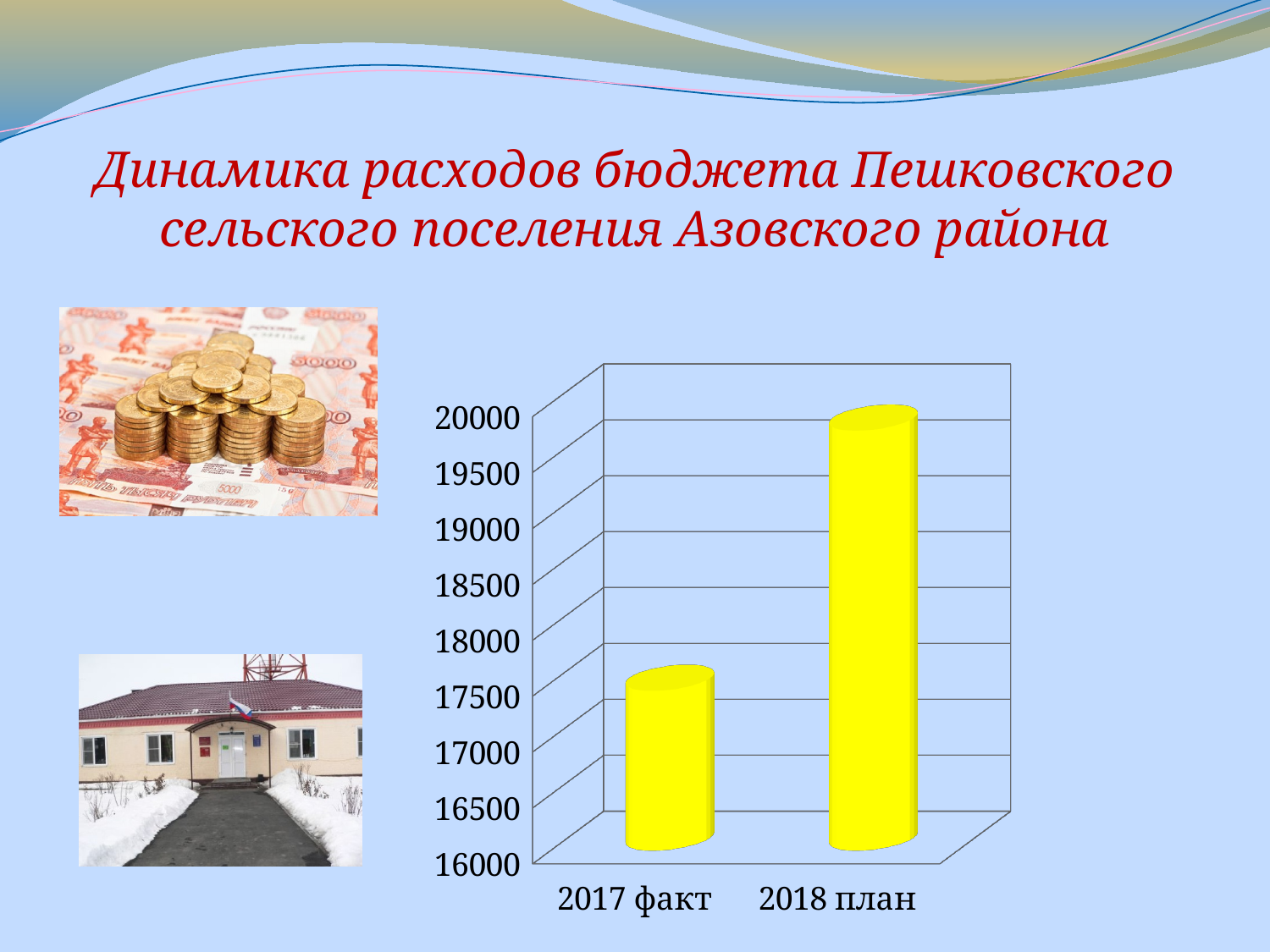
Is the value for 2018 план greater or less than 19000? greater What kind of chart is shown on the slide? bar chart What is the lowest value shown on the vertical axis of the chart? 16000 Which category has the lowest value in the chart? 2017 факт How many categories are shown on the x axis of the chart? 2 Is the value for 2017 факт greater or less than 18000? less Is the value for 2017 факт greater or less than 17000? greater Which category has the highest value in the chart? 2018 план Do the values rise or fall from 2017 факт to 2018 план? rise What colour are the bars in the chart? yellow Which is larger, the value for 2017 факт or the value for 2018 план? 2018 план